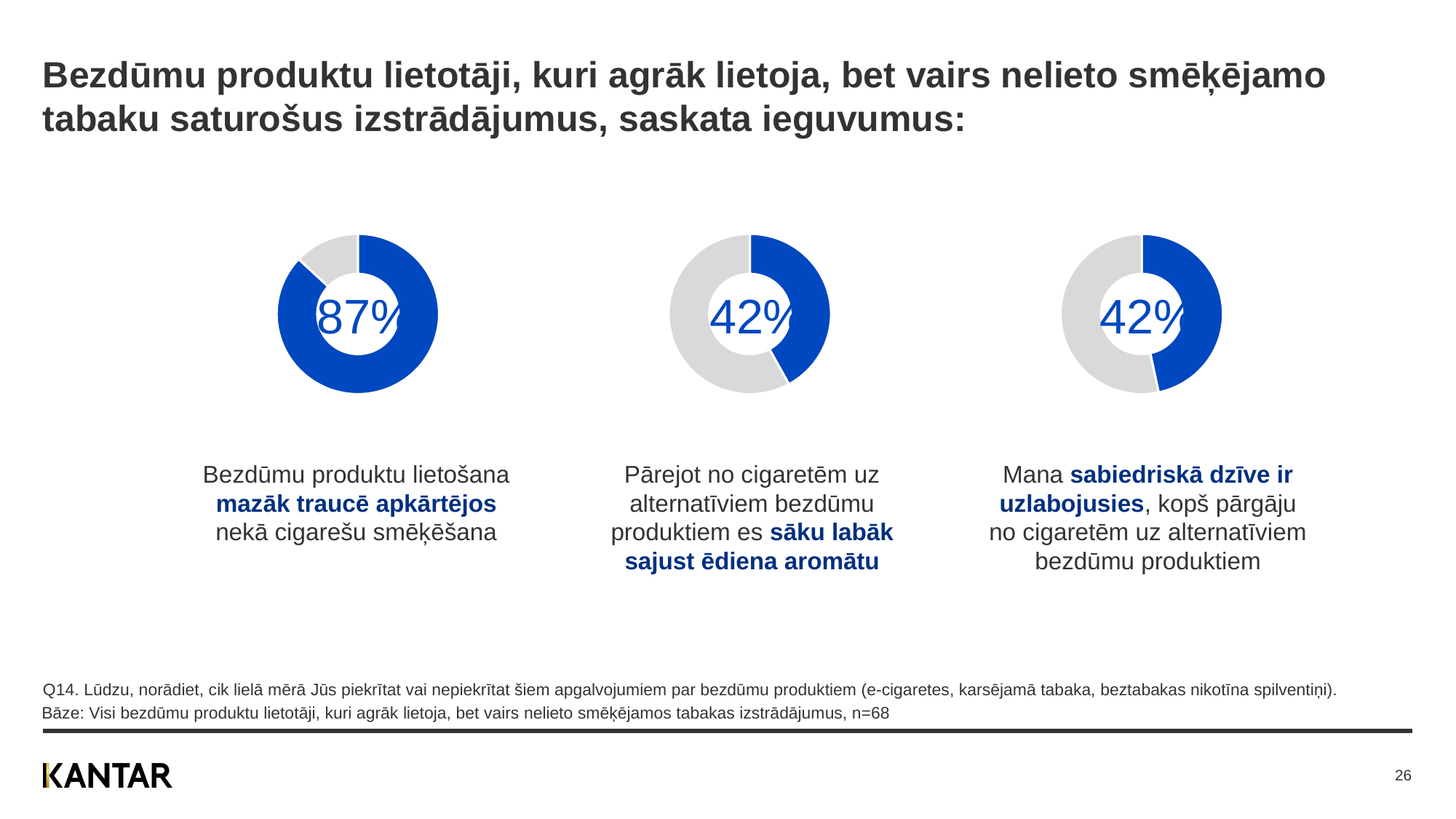
In the left donut chart (Bezdūmu produktu lietošana mazāk traucē apkārtējos nekā cigarešu smēķēšana), what percentage is shown? 87% Is the value in the left donut chart greater or less than 50%? greater What is the difference between the left donut chart value (87%) and the middle donut chart value (42%)? 45 percentage points In the middle donut chart (sāku labāk sajust ēdiena aromātu), what percentage is shown? 42% In the left donut chart, what share is represented by the grey (remaining) segment? 13% Which of the three donut charts shows the highest percentage? The left chart (87%) In the right donut chart (sabiedriskā dzīve ir uzlabojusies), what percentage is shown? 42% What kind of chart is used for the three figures on the slide? donut (pie) chart What colour is used for the highlighted (agreeing) segment in each donut chart? Blue How many donut charts are shown on the slide? 3 Which is larger: the value in the left donut chart or the value in the middle donut chart? The left chart (87%) Is the value in the middle donut chart greater or less than 50%? less